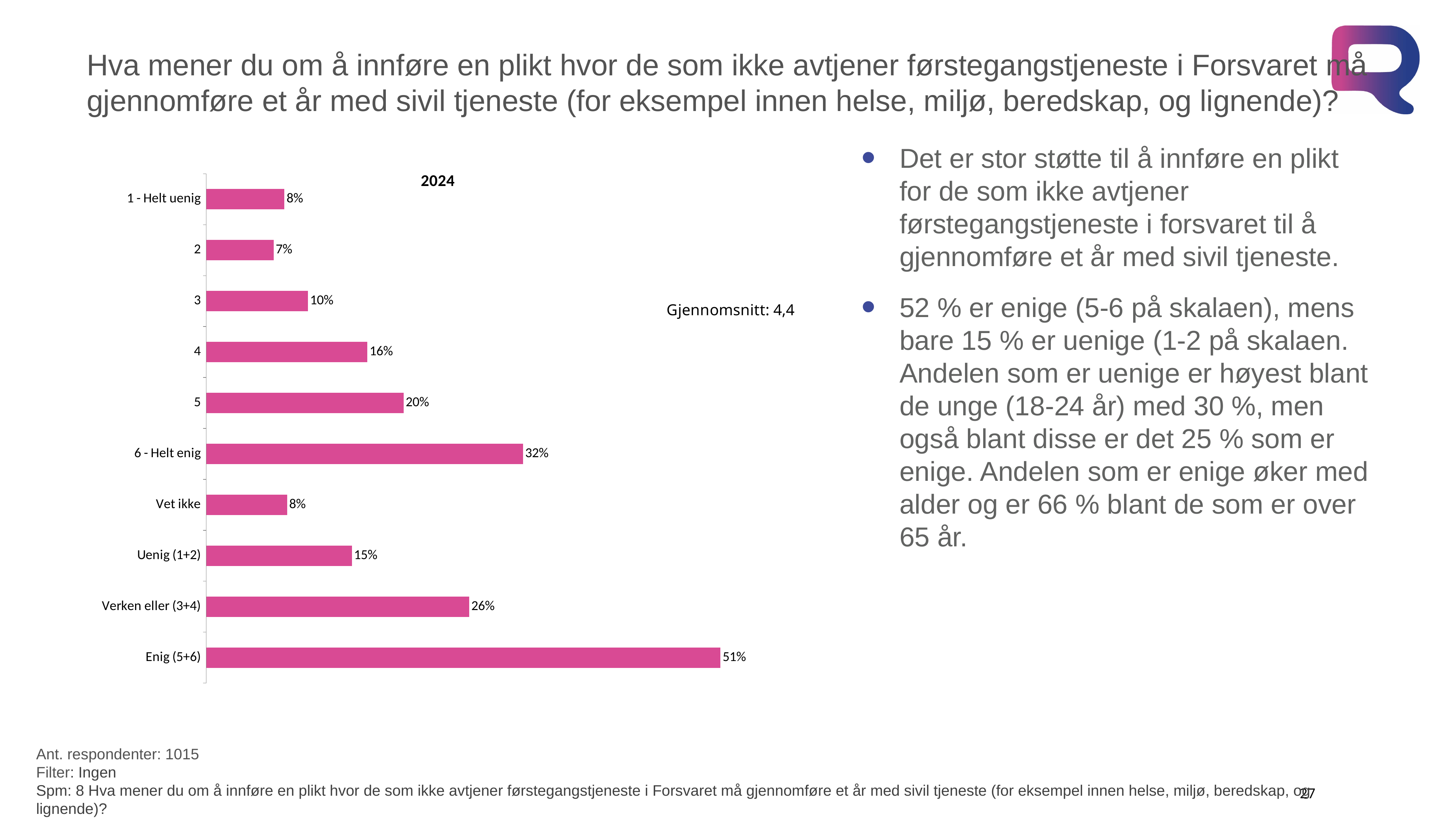
Which is larger, the value for "3" or the value for "5"? 5 What is the value for "Vet ikke"? 8% What kind of chart is shown on the slide? Bar chart Which category has the highest value? Enig (5+6) What is the value for category "4"? 16% What average (Gjennomsnitt) is shown next to the chart? 4,4 What is the value for "Verken eller (3+4)"? 26% How many categories are shown in the chart? 10 Which category has the lowest value? 2 What is the difference between "6 - Helt enig" and "5"? 12% What is the value for "6 - Helt enig"? 32% What is the difference between "Enig (5+6)" and "Uenig (1+2)"? 36%